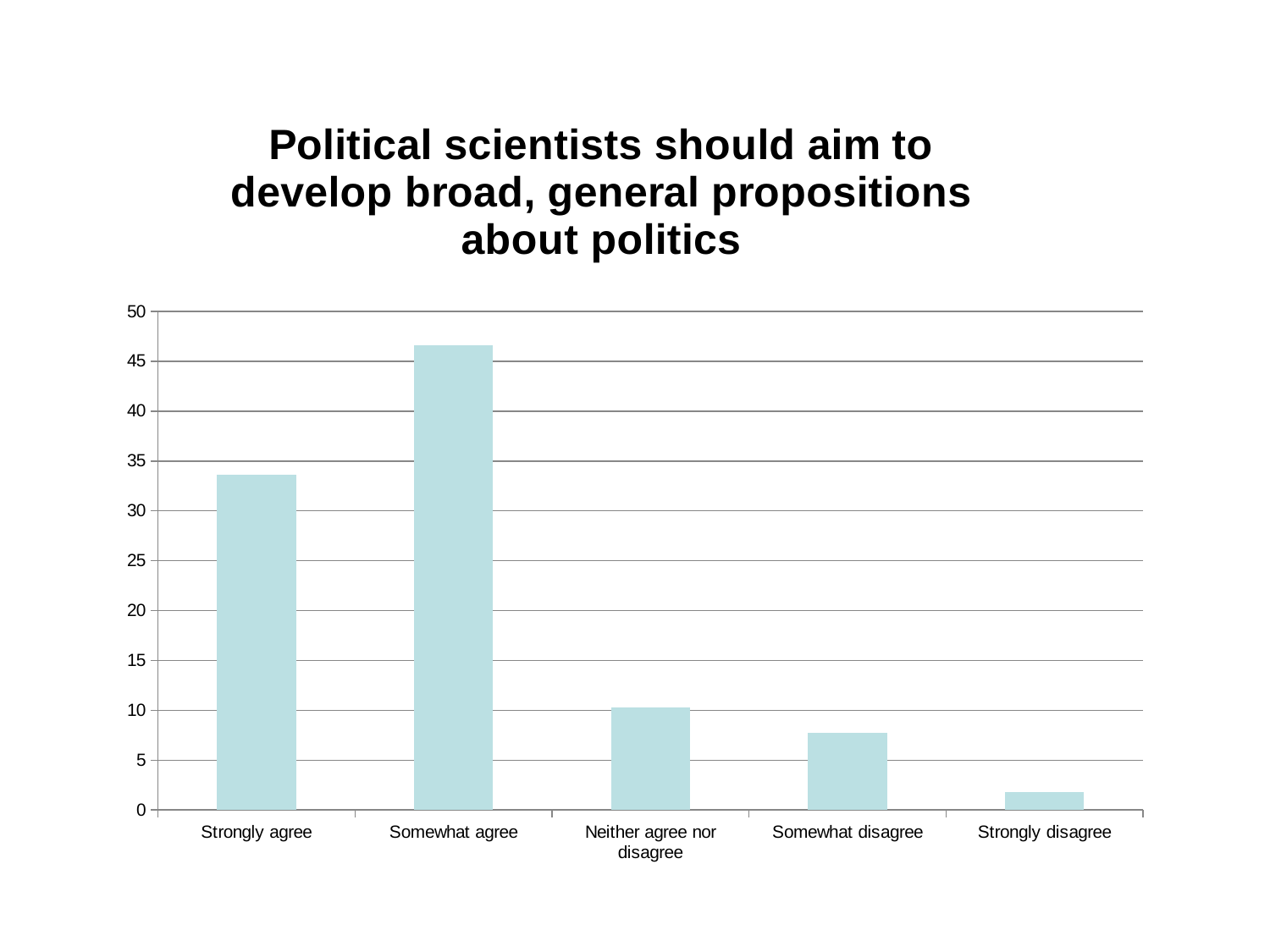
Which category has the lowest value? Strongly disagree Is the value for Somewhat agree greater or less than 45? greater How many categories are shown on the x axis? 5 What kind of chart is shown on the slide? bar chart What is the title of the chart? Political scientists should aim to develop broad, general propositions about politics Is the value for Somewhat disagree greater or less than 10? less Is the value for Strongly agree greater or less than 35? less Which is larger, the value for Strongly agree or the value for Somewhat agree? Somewhat agree Which category has the highest value? Somewhat agree Which is larger, the value for Neither agree nor disagree or the value for Somewhat disagree? Neither agree nor disagree